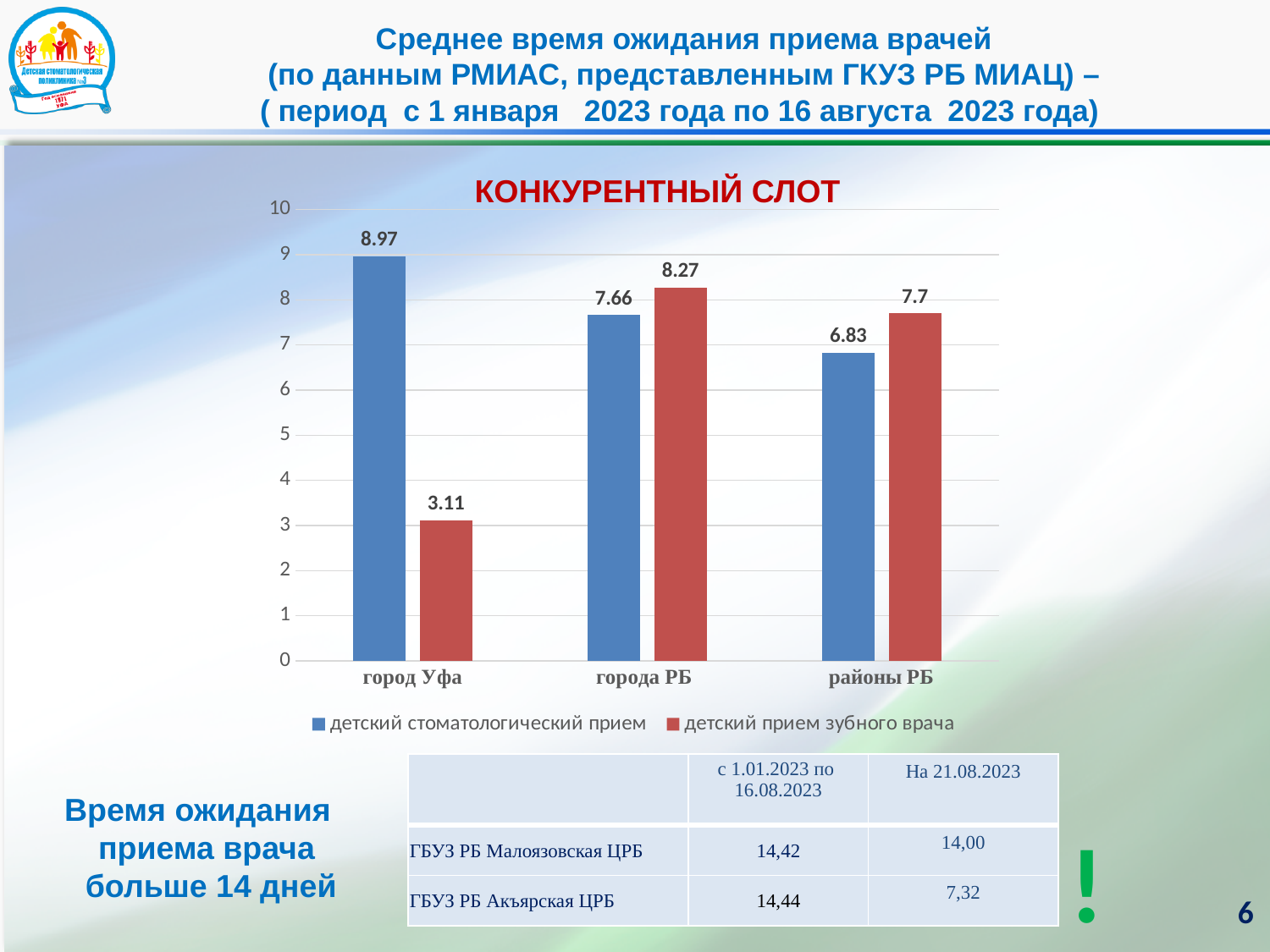
How many series does the chart legend list? 2 In города РБ, which series has the larger value: детский стоматологический прием or детский прием зубного врача? детский прием зубного врача Which category has the lowest value for детский прием зубного врача? город Уфа Do the values for детский стоматологический прием rise or fall from город Уфа to районы РБ? fall How many categories are shown on the x axis of the chart? 3 What is the difference between детский стоматологический прием and детский прием зубного врача in город Уфа? 5.86 What is the value for детский прием зубного врача in города РБ? 8.27 What is the value for детский прием зубного врача in город Уфа? 3.11 What kind of chart is shown on the slide? bar chart What is the value for детский стоматологический прием in город Уфа? 8.97 Which category has the highest value for детский стоматологический прием? город Уфа What is the value for детский стоматологический прием in районы РБ? 6.83